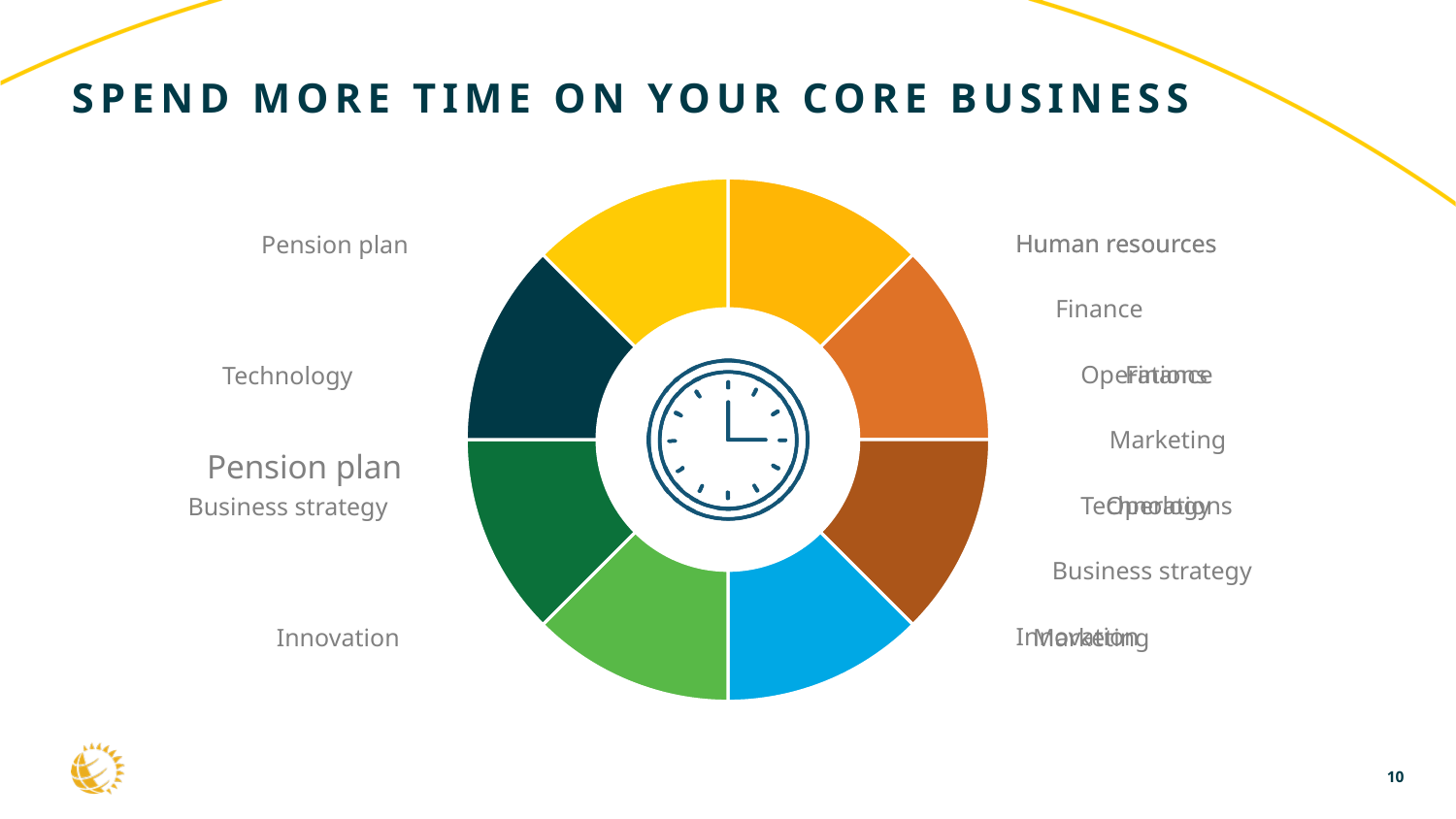
How many segments does the donut chart have? 8 What is the title of the slide containing the donut chart? SPEND MORE TIME ON YOUR CORE BUSINESS Are the segments of the donut chart equal in size, or does one stand out as larger? Equal in size What kind of chart is shown on the slide? Donut (pie) chart What icon is shown in the centre of the donut chart? A clock